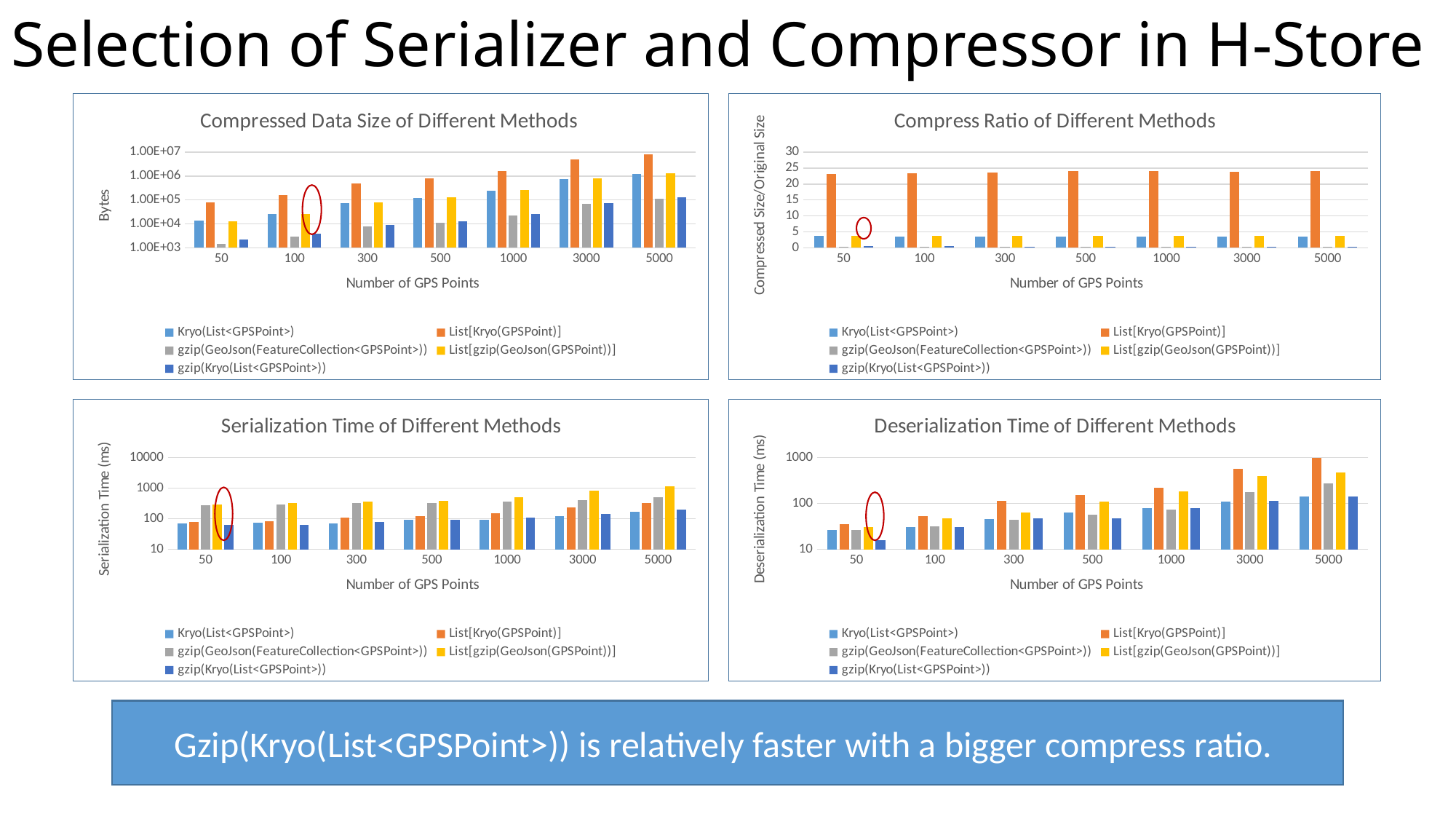
In the 'Deserialization Time of Different Methods' chart, which series has the highest deserialization time at 5000 GPS points? List[Kryo(GPSPoint)] In the 'Serialization Time of Different Methods' chart, which series has the highest serialization time at 5000 GPS points? List[gzip(GeoJson(GPSPoint))] In the 'Compressed Data Size of Different Methods' chart, at 5000 GPS points, which is larger: List[Kryo(GPSPoint)] or gzip(Kryo(List<GPSPoint>))? List[Kryo(GPSPoint)] In the 'Compress Ratio of Different Methods' chart, which series has the highest compress ratio? List[Kryo(GPSPoint)] In the 'Compress Ratio of Different Methods' chart, is the value for List[Kryo(GPSPoint)] at 50 GPS points greater or less than 20? greater In the 'Compress Ratio of Different Methods' chart, is the value for Kryo(List<GPSPoint>) at 5000 GPS points greater or less than 10? less What kind of chart is the 'Compressed Data Size of Different Methods' chart? bar chart In the 'Compressed Data Size of Different Methods' chart, how many categories are shown on the x axis? 7 In the 'Compressed Data Size of Different Methods' chart, does the value for List[Kryo(GPSPoint)] rise or fall as the number of GPS points increases? rise How many series does the legend of the 'Compress Ratio of Different Methods' chart list? 5 What is the y-axis title of the 'Compress Ratio of Different Methods' chart? Compressed Size/Original Size In the 'Deserialization Time of Different Methods' chart, is the value for List[Kryo(GPSPoint)] at 5000 GPS points greater or less than 100? greater